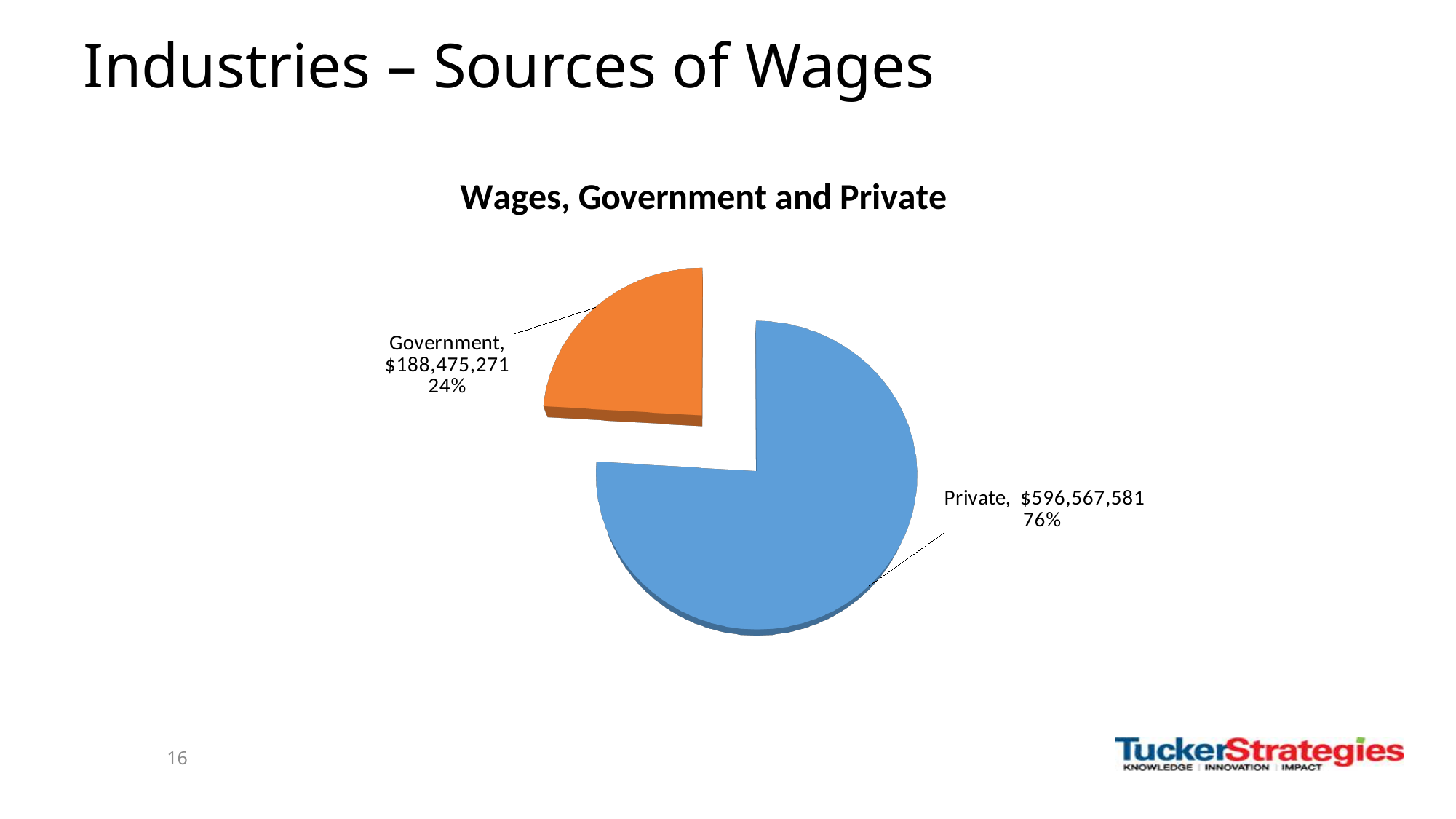
Which is larger, Government wages or Private wages? Private What share of wages comes from Government? 24% What type of chart is shown on the slide? Pie chart What colour is the Government slice of the pie chart? Orange Which source of wages is the largest? Private What share of wages comes from Private? 76% What is the title of the chart? Wages, Government and Private Which source of wages is the smallest? Government What is the wage value for Government? $188,475,271 How many slices does the pie chart have? 2 What is the wage value for Private? $596,567,581 What is the difference between Private wages and Government wages? $408,092,310